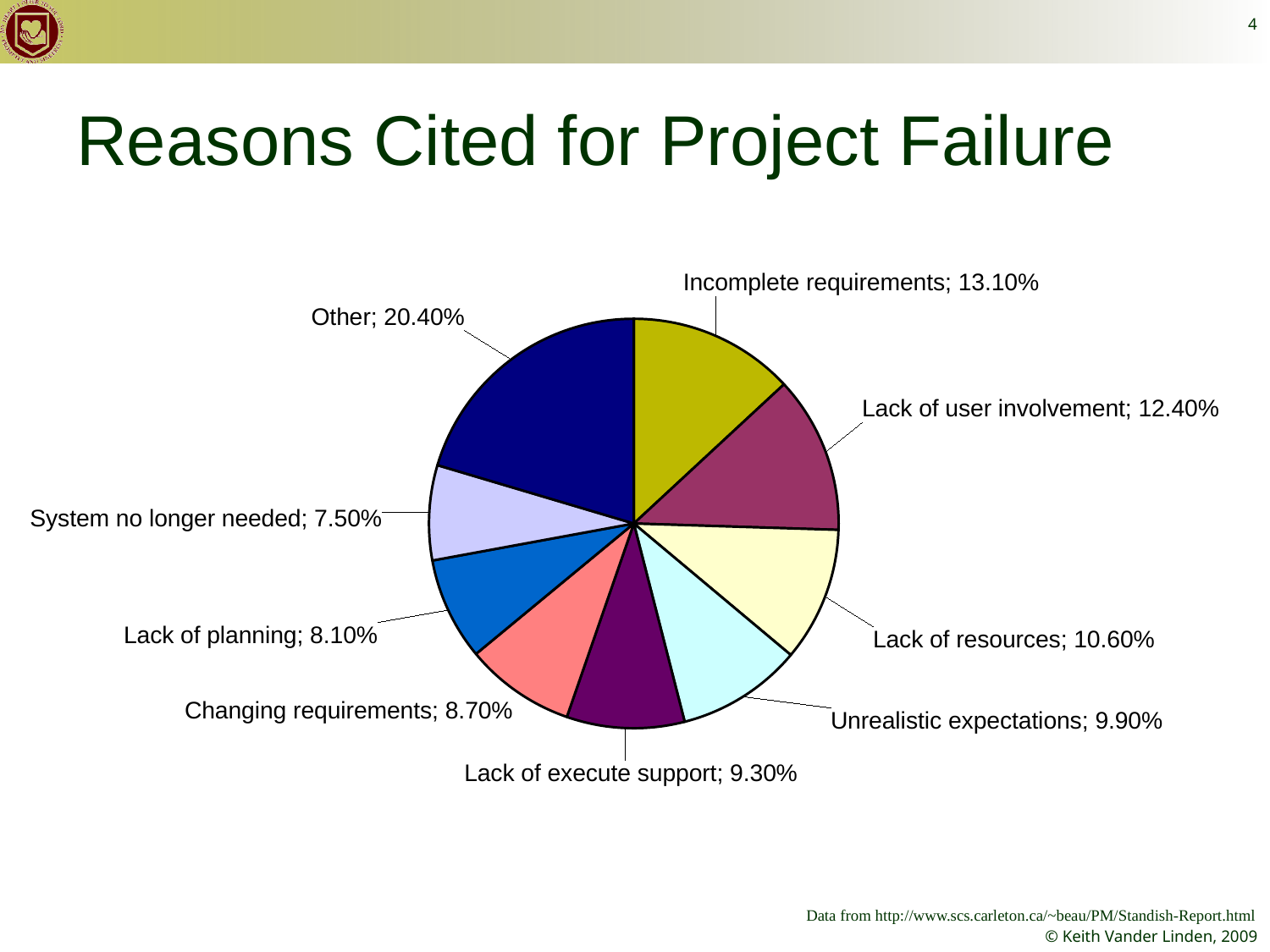
How many slices does the pie chart have? 9 What type of chart is shown on the slide? Pie chart Which category has the largest slice of the pie? Other What is the difference between the percentages for Incomplete requirements and Lack of user involvement? 0.70% Which category has the smallest slice of the pie? System no longer needed What percentage is shown for Incomplete requirements? 13.10% What is the title of the chart? Reasons Cited for Project Failure Which is larger, the slice for Lack of planning or the slice for Changing requirements? Changing requirements What percentage is shown for Changing requirements? 8.70% What share of the pie does Unrealistic expectations represent? 9.90% What percentage is shown for Lack of resources? 10.60% What is the difference between the percentages for Other and Lack of resources? 9.80%